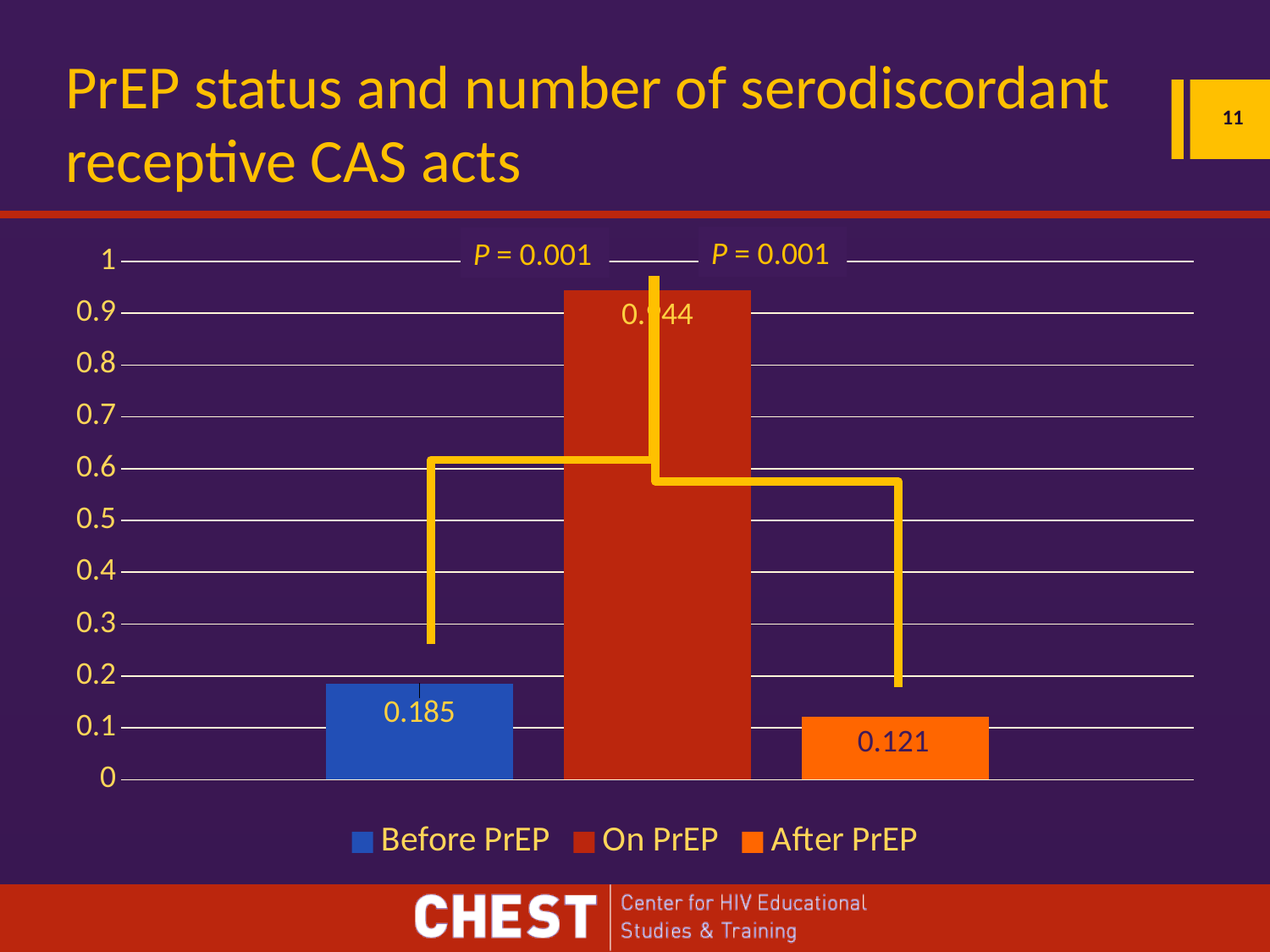
How many series does the legend list? 3 What kind of chart is shown on the slide? bar chart Which PrEP status has the highest value? On PrEP What is the value for After PrEP? 0.121 What is the value for Before PrEP? 0.185 What is the difference between the Before PrEP value and the After PrEP value? 0.064 Which is larger, the value for Before PrEP or the value for After PrEP? Before PrEP What P value is shown above the chart for the comparisons between groups? P = 0.001 Is the value for On PrEP greater or less than 0.9? greater Which PrEP status has the lowest value? After PrEP How many bars are plotted in the chart? 3 Is the value for Before PrEP greater or less than 0.2? less